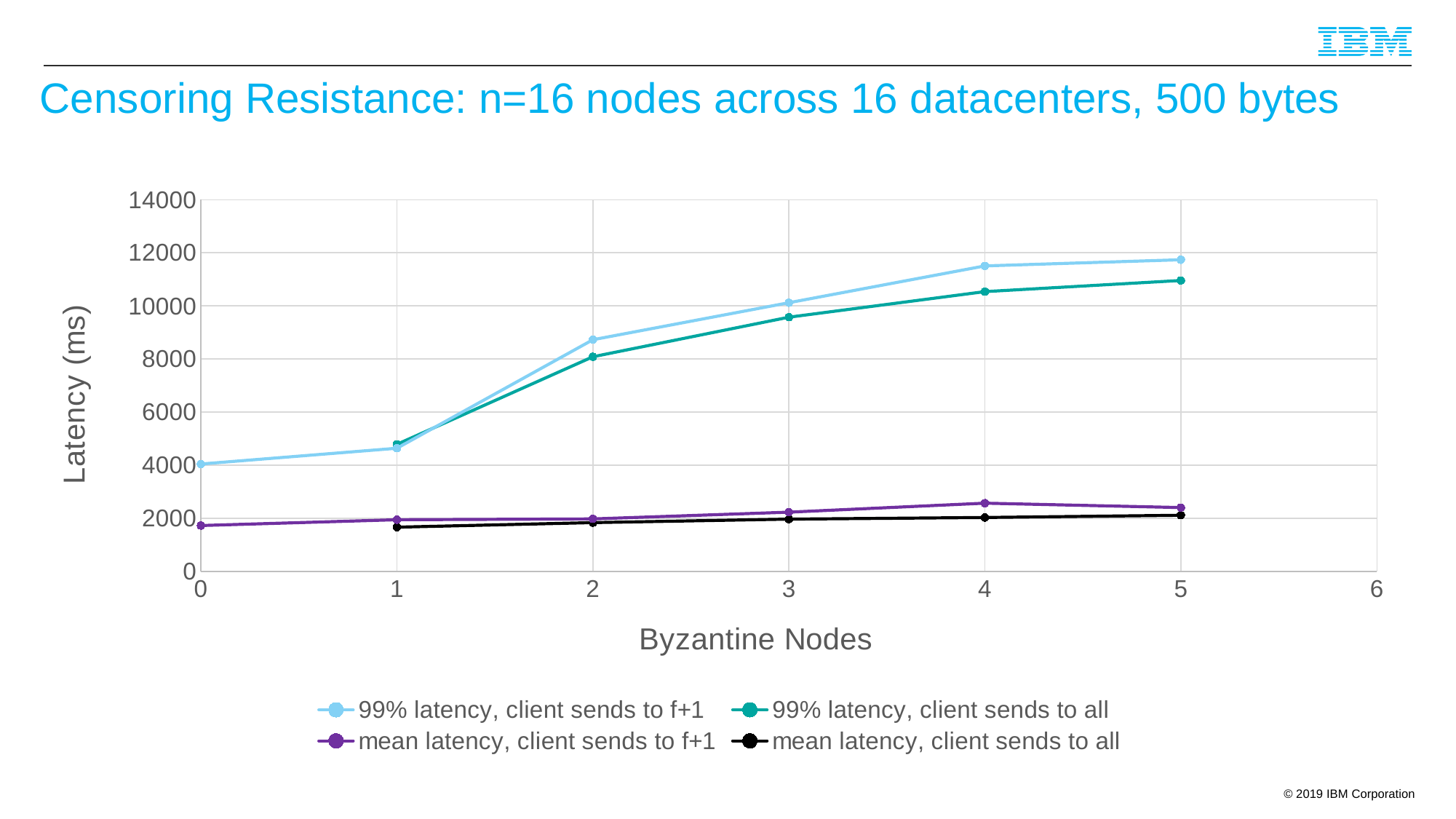
Is the value for 'mean latency, client sends to all' at 1 Byzantine node greater or less than 2000? less Which series has the highest value at 5 Byzantine nodes? 99% latency, client sends to f+1 Does the '99% latency, client sends to f+1' series rise or fall as the number of Byzantine nodes increases? rise What is the title of the x axis? Byzantine Nodes At 4 Byzantine nodes, which is larger: 'mean latency, client sends to f+1' or 'mean latency, client sends to all'? mean latency, client sends to f+1 Is the value for '99% latency, client sends to f+1' at 5 Byzantine nodes greater or less than 10000? greater What kind of chart is shown on the slide? line chart At 5 Byzantine nodes, which is larger: '99% latency, client sends to f+1' or '99% latency, client sends to all'? 99% latency, client sends to f+1 Is the value for '99% latency, client sends to all' at 2 Byzantine nodes greater or less than 10000? less How many series does the legend list? 4 What is the title of the y axis? Latency (ms)